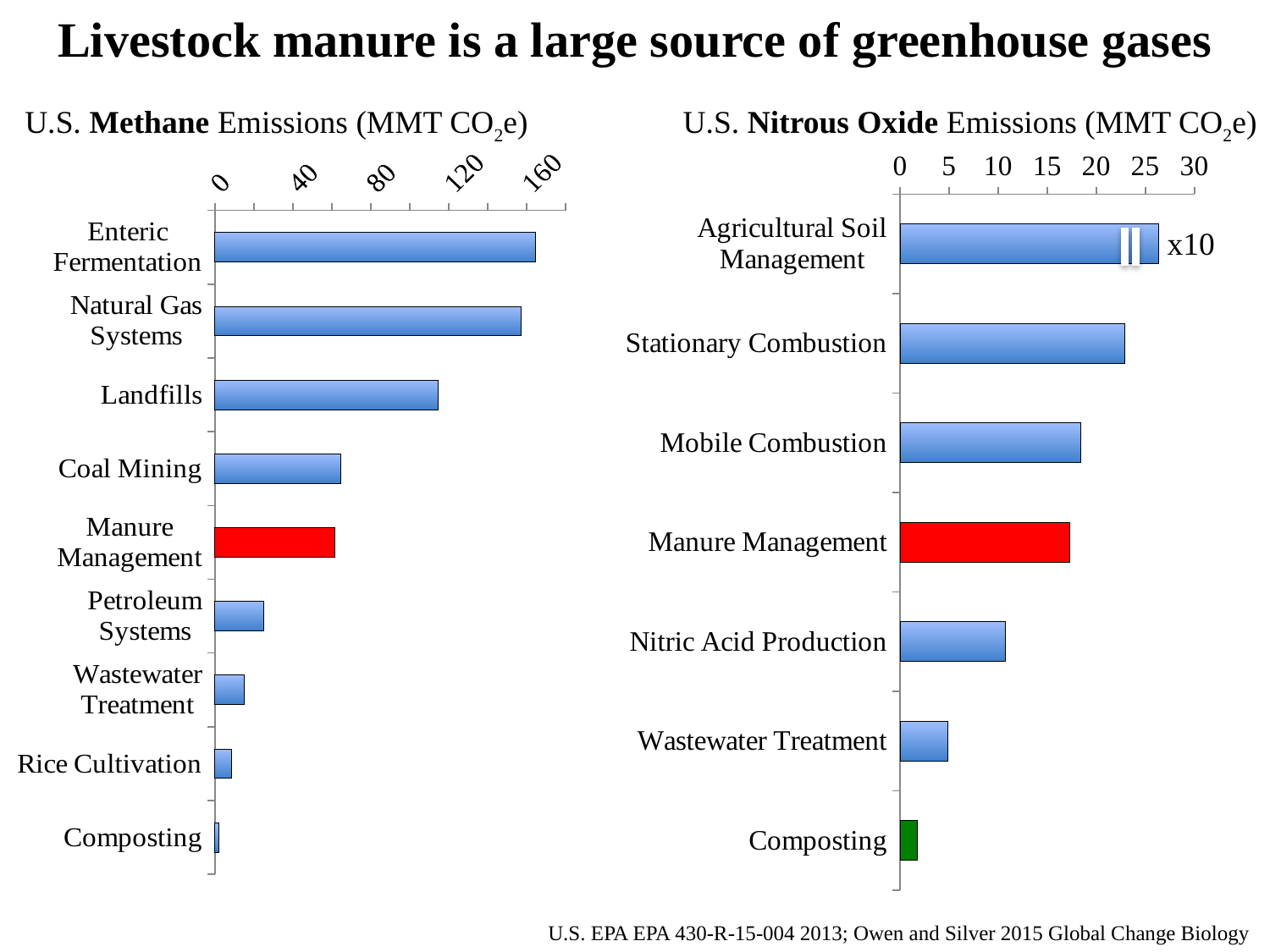
In the U.S. Methane Emissions chart on the left, which category is shown with a red bar? Manure Management How many categories are shown in the U.S. Methane Emissions chart on the left? 9 In the U.S. Methane Emissions chart on the left, which category has the highest value? Enteric Fermentation In the U.S. Methane Emissions chart on the left, is the value for Petroleum Systems greater or less than 40? less In the U.S. Methane Emissions chart on the left, which is larger: Landfills or Coal Mining? Landfills In the U.S. Methane Emissions chart on the left, which category has the lowest value? Composting How many categories are shown in the U.S. Nitrous Oxide Emissions chart on the right? 7 What kind of chart is the U.S. Methane Emissions chart on the left? bar chart In the U.S. Nitrous Oxide Emissions chart on the right, which category has the lowest value? Composting In the U.S. Nitrous Oxide Emissions chart on the right, which is larger: Mobile Combustion or Nitric Acid Production? Mobile Combustion In the U.S. Nitrous Oxide Emissions chart on the right, is the value for Stationary Combustion greater or less than 20? greater In the U.S. Methane Emissions chart on the left, is the value for Landfills greater or less than 80? greater